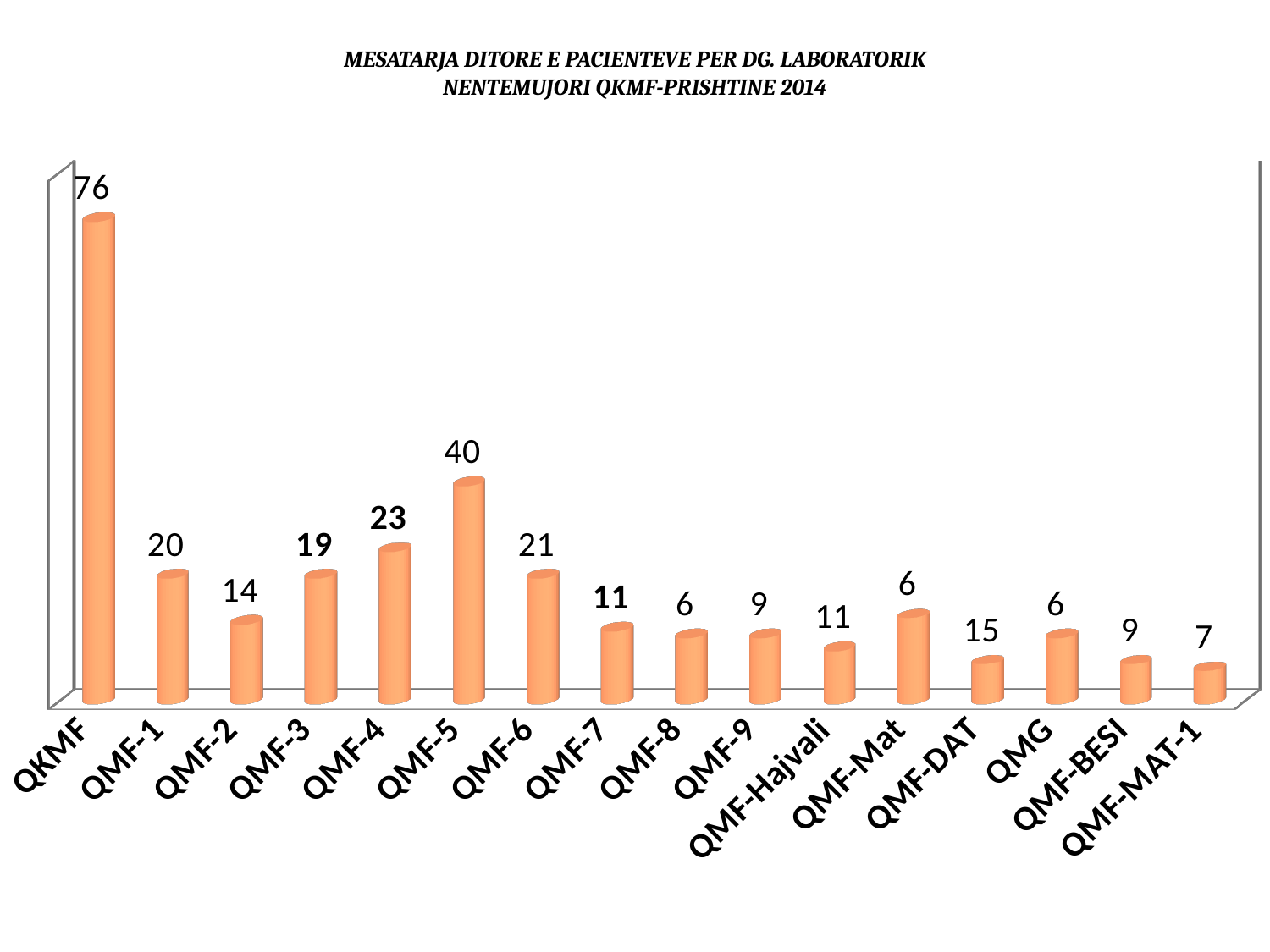
What year is mentioned in the chart title? 2014 What is the value for QKMF? 76 What is the difference between the values for QMF-4 and QMF-3? 4 What is the value for QMF-Hajvali? 11 What is the value for QMF-DAT? 15 How many categories are shown on the chart? 16 What is the value for QMF-5? 40 What kind of chart is shown on the slide? Bar chart Which is larger, the value for QMF-6 or the value for QMF-1? QMF-6 Which category has the highest value? QKMF What is the lowest value shown on the chart? 6 What is the difference between the values for QKMF and QMF-5? 36